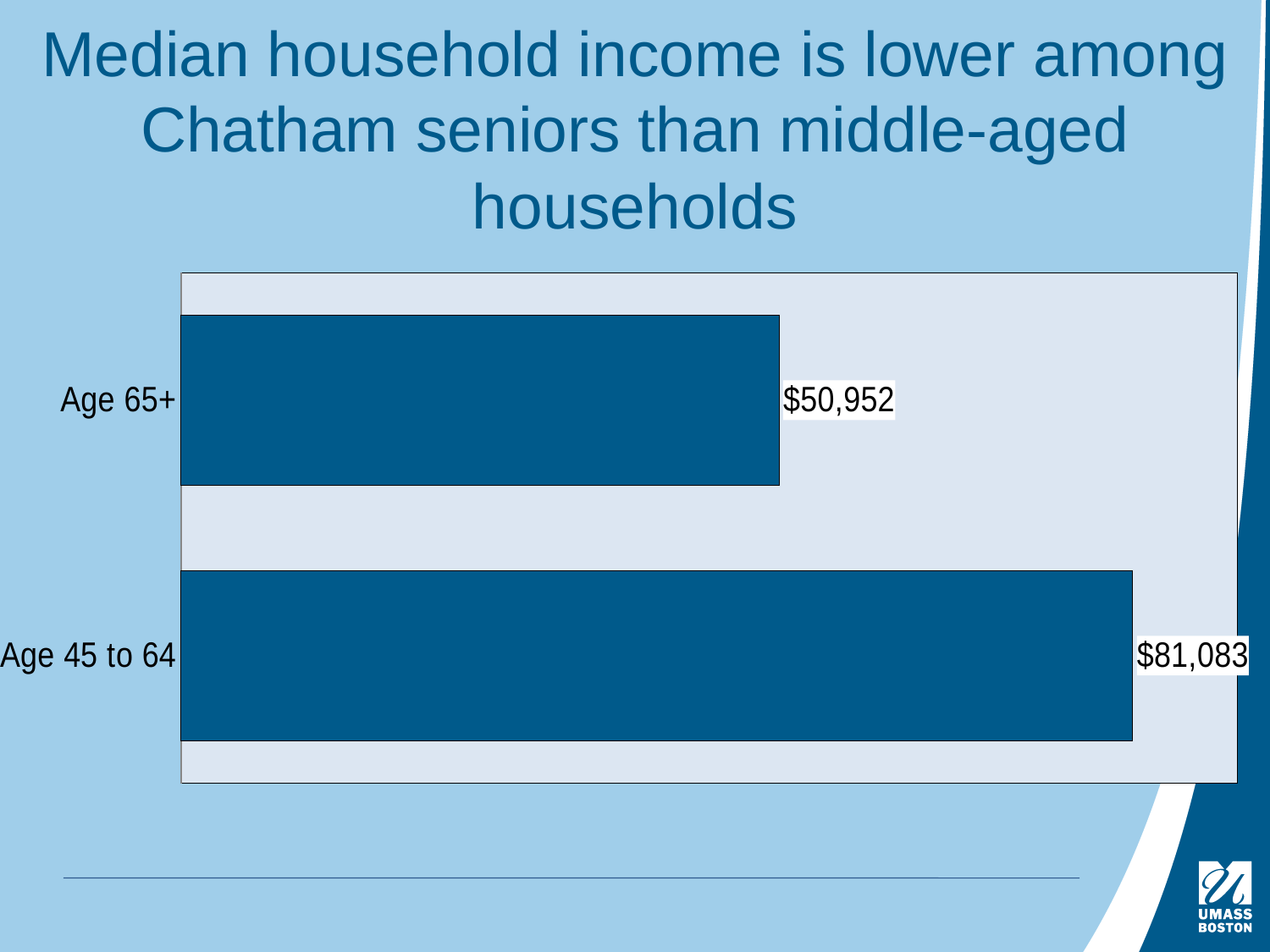
Which age group has the lower median household income? Age 65+ What is the title of the slide? Median household income is lower among Chatham seniors than middle-aged households Which age group has the higher median household income? Age 45 to 64 How many age groups are shown in the chart? 2 What is the median household income for Age 65+? $50,952 Are the bars in the chart horizontal or vertical? Horizontal What is the median household income for Age 45 to 64? $81,083 Is the median household income larger for Age 65+ or for Age 45 to 64? Age 45 to 64 What kind of chart is shown on the slide? Bar chart What is the difference in median household income between Age 45 to 64 and Age 65+? $30,131